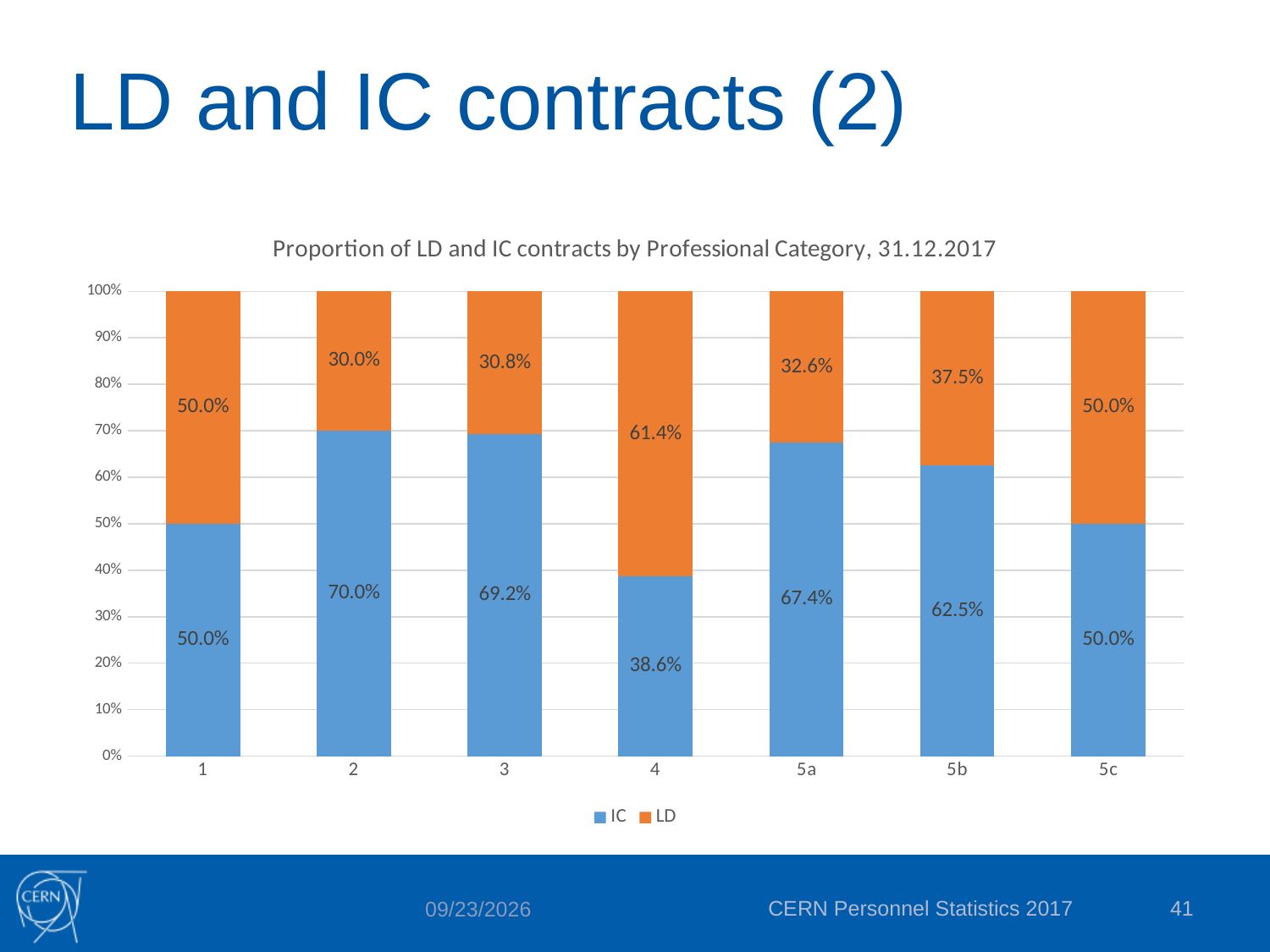
What is the IC value for category 5b? 62.5% Which category has the lowest IC proportion? 4 What is the IC value for category 2? 70.0% What is the difference between the IC value for category 2 and the IC value for category 4? 31.4% What is the title of the chart? Proportion of LD and IC contracts by Professional Category, 31.12.2017 What is the LD value for category 5a? 32.6% How many categories are shown on the x axis? 7 Which category has the highest IC proportion? 2 What kind of chart is shown on the slide? Stacked bar chart How many series does the legend list? 2 What is the LD value for category 4? 61.4% Which is larger, the LD value for category 5b or the LD value for category 3? LD value for category 5b